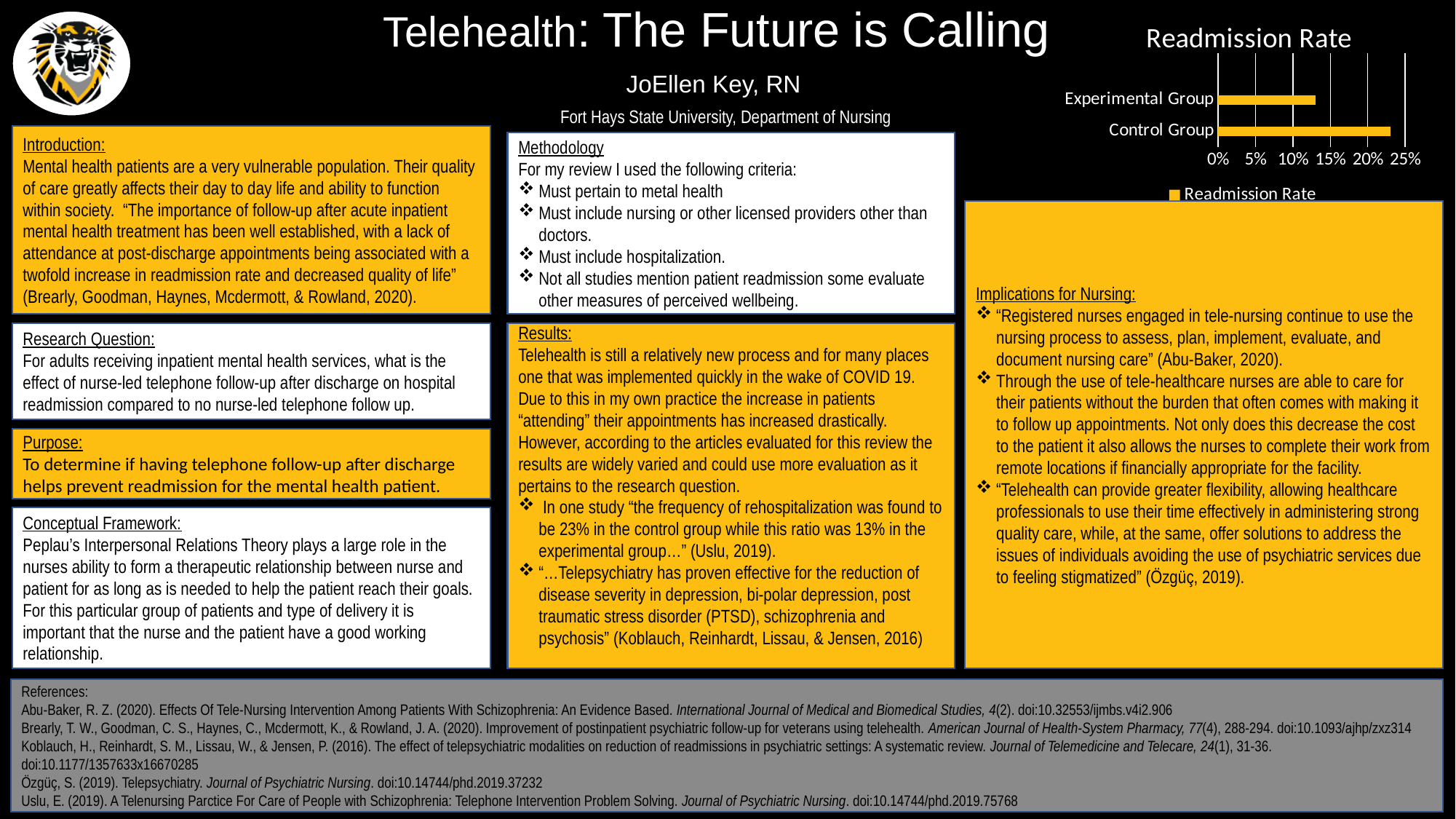
In the Readmission Rate chart, is the value for the Experimental Group greater or less than 10%? greater In the Readmission Rate chart, is the value for the Control Group greater or less than 25%? less Which group has the higher readmission rate in the Readmission Rate chart? Control Group What is the title of the chart on the slide? Readmission Rate In the Readmission Rate chart, is the value for the Control Group greater or less than 20%? greater Which group has the lower readmission rate in the Readmission Rate chart? Experimental Group In the Readmission Rate chart, is the value for the Experimental Group larger or smaller than the value for the Control Group? smaller What is the highest value shown on the x axis of the Readmission Rate chart? 25% What kind of chart is the Readmission Rate chart? bar chart How many series does the legend of the Readmission Rate chart list? 1 How many categories are shown in the Readmission Rate chart? 2